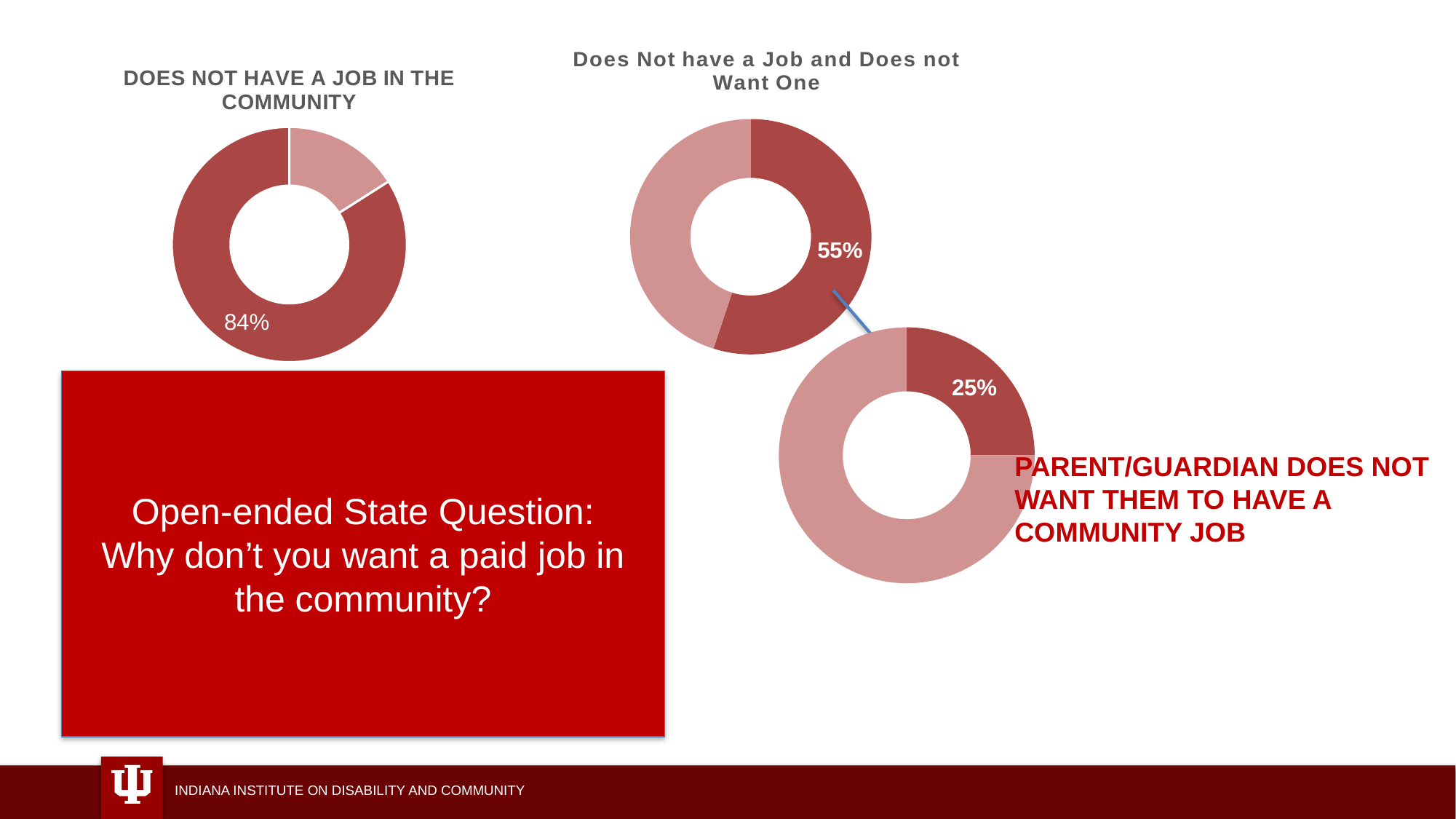
Which is larger: the labelled value in the "DOES NOT HAVE A JOB IN THE COMMUNITY" chart or the labelled value in the "Does Not have a Job and Does not Want One" chart? DOES NOT HAVE A JOB IN THE COMMUNITY (84%) What kind of chart is the "DOES NOT HAVE A JOB IN THE COMMUNITY" chart? Donut (pie) chart In the chart titled "Does Not have a Job and Does not Want One", what percentage is printed on the dark slice? 55% Which of the three donut charts has the largest labelled percentage? DOES NOT HAVE A JOB IN THE COMMUNITY (84%) What is the title of the donut chart at the top right of the slide? Does Not have a Job and Does not Want One What is the difference between the labelled value in the "Does Not have a Job and Does not Want One" chart and the labelled value in the "PARENT/GUARDIAN DOES NOT WANT THEM TO HAVE A COMMUNITY JOB" chart? 30 percentage points In the chart titled "DOES NOT HAVE A JOB IN THE COMMUNITY", what percentage is printed on the large dark slice? 84% In the "Does Not have a Job and Does not Want One" chart, is the dark slice greater or less than half of the donut? greater How many donut charts are shown on the slide? 3 In the chart labelled "PARENT/GUARDIAN DOES NOT WANT THEM TO HAVE A COMMUNITY JOB", what percentage is printed on the dark slice? 25% How many slices does the "Does Not have a Job and Does not Want One" chart have? 2 Which of the three donut charts has the smallest labelled percentage? PARENT/GUARDIAN DOES NOT WANT THEM TO HAVE A COMMUNITY JOB (25%)